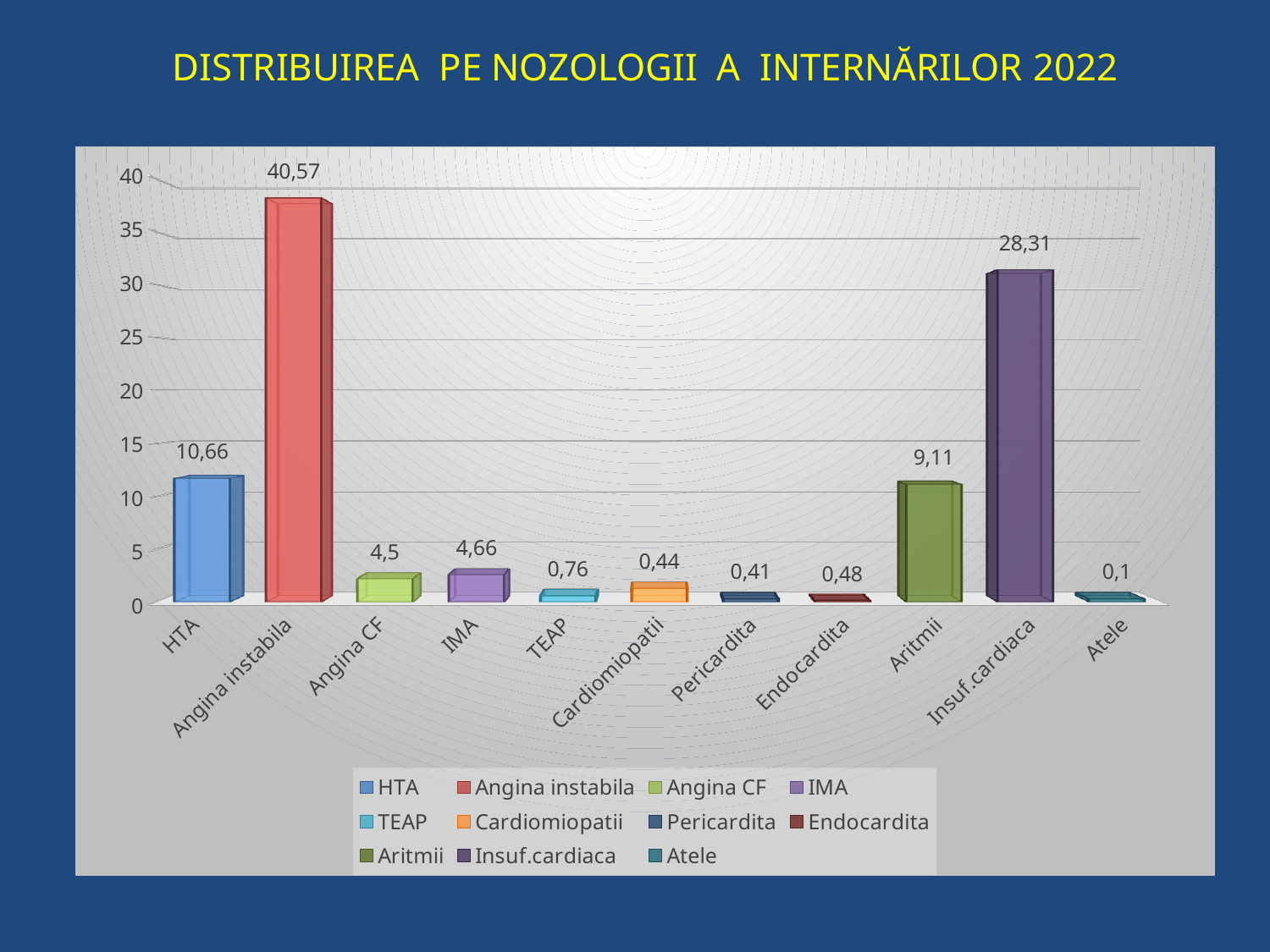
What is the value for Aritmii? 9,11 How many categories are shown on the x axis? 11 How many entries does the legend list? 11 Which category has the lowest value? Atele What is the value for Insuf.cardiaca? 28,31 Which is larger, the value for HTA or the value for Aritmii? HTA Which category has the highest value? Angina instabila What is the difference between the values for Angina instabila and Insuf.cardiaca? 12,26 What is the value for HTA? 10,66 What kind of chart is shown on the slide? Bar chart What is the value for Atele? 0,1 What is the value for Angina instabila? 40,57